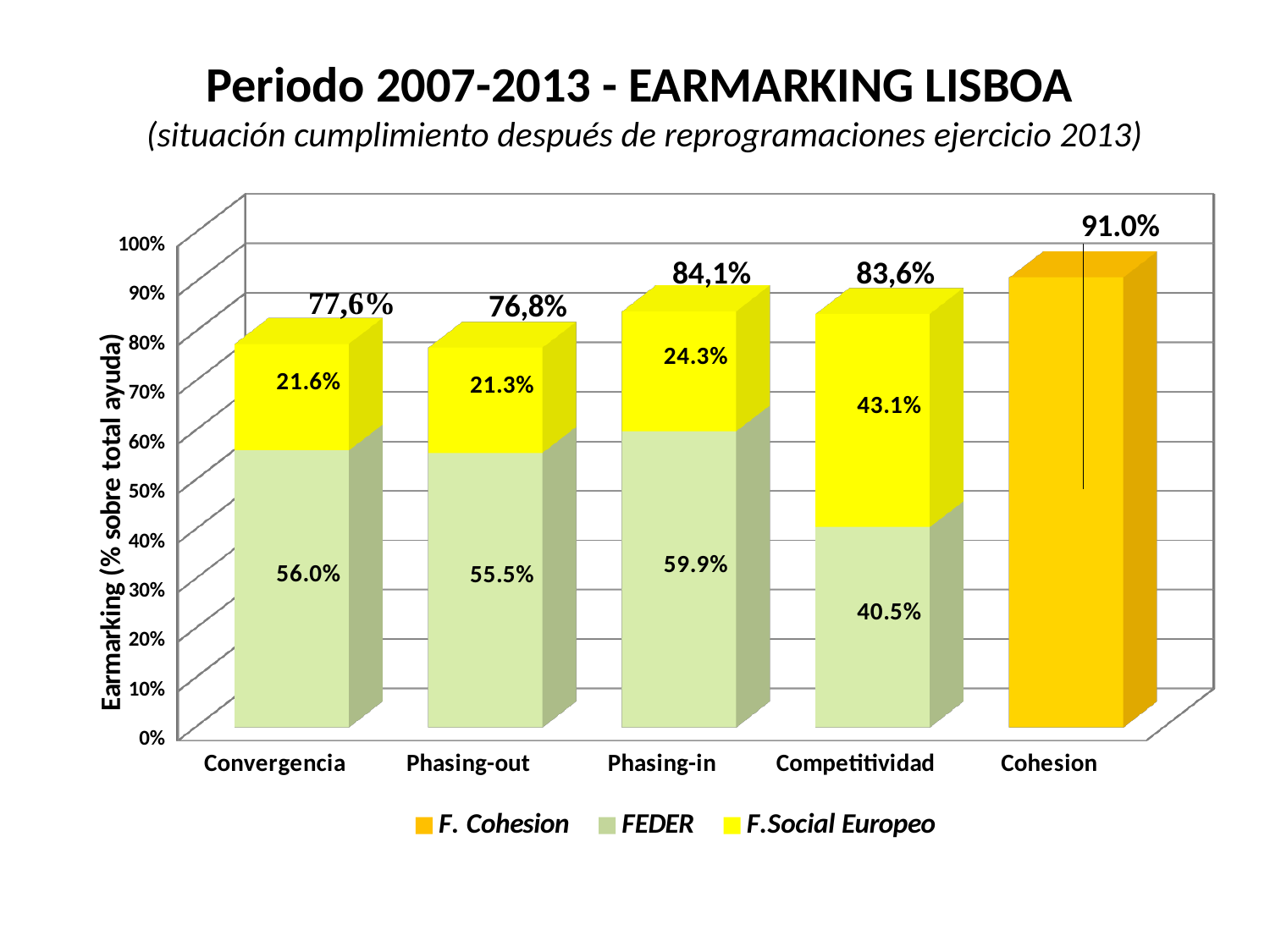
How many series does the legend list? 3 Which category has the lowest FEDER value? Competitividad What is the F.Social Europeo value for Competitividad? 43.1% What is the label of the y axis? Earmarking (% sobre total ayuda) How many categories are shown on the x axis? 5 What is the value shown for the Cohesion bar? 91.0% Which is larger, the F.Social Europeo value for Convergencia or for Phasing-in? Phasing-in What is the FEDER value for Convergencia? 56.0% What is the difference between the FEDER values for Phasing-in and Phasing-out? 4.4% What kind of chart is shown on the slide? Stacked bar chart What total is printed above the Phasing-in bar? 84,1% Which category has the highest F.Social Europeo value? Competitividad